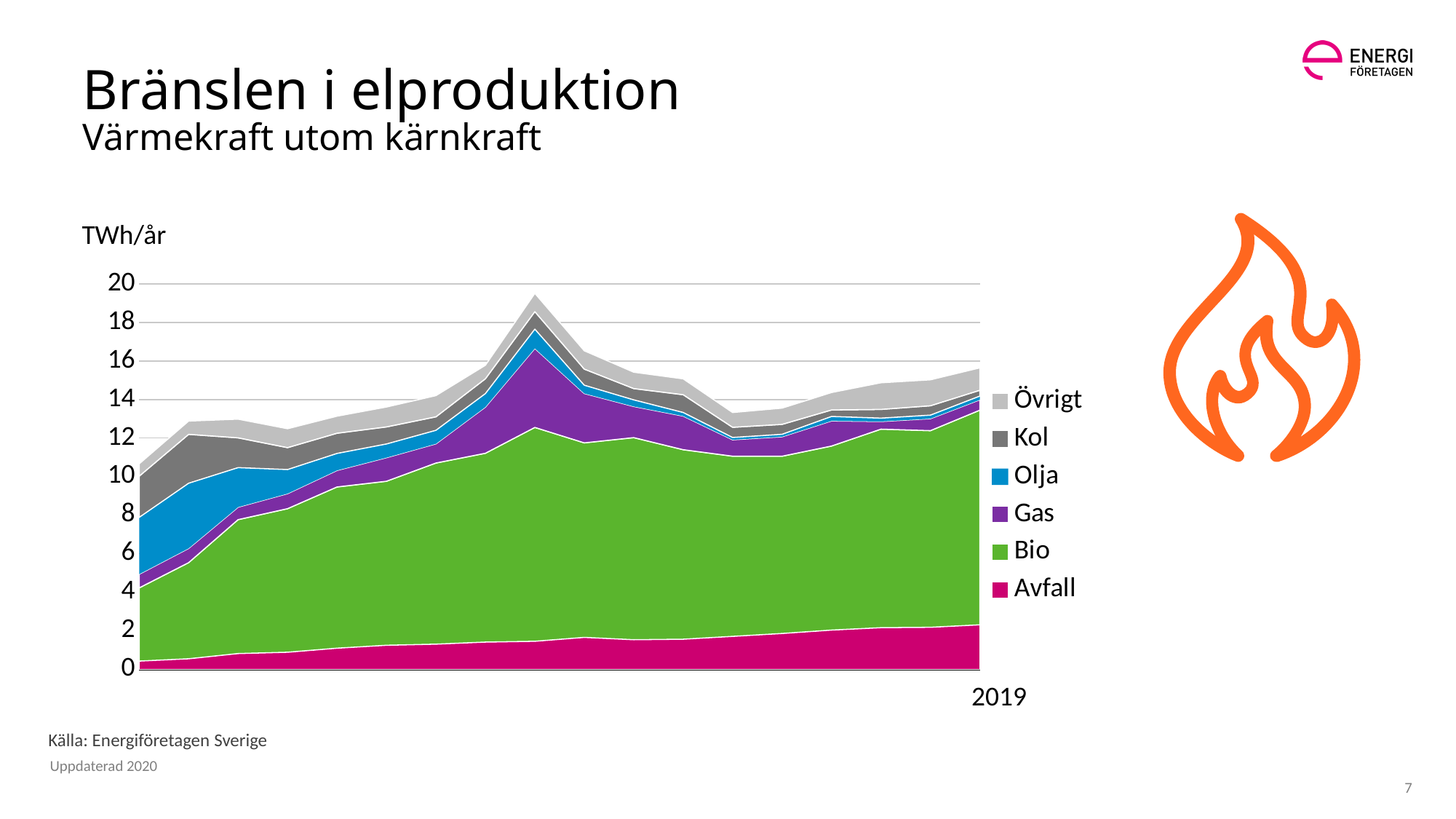
How many series does the legend list? 6 What kind of chart is shown on the slide? Stacked area chart Is the total stacked value in 2019 greater or less than 16? less Is the value for Avfall in 2019 greater or less than 4? less Does the Avfall series rise or fall along the x axis? rise Is the highest peak of the stacked total greater or less than 20? less Which series takes up the largest area of the chart? Bio Which is larger in 2019, the Bio area or the Olja area? Bio What is the title of the chart on the slide? Bränslen i elproduktion What unit is shown on the y axis of the chart? TWh/år